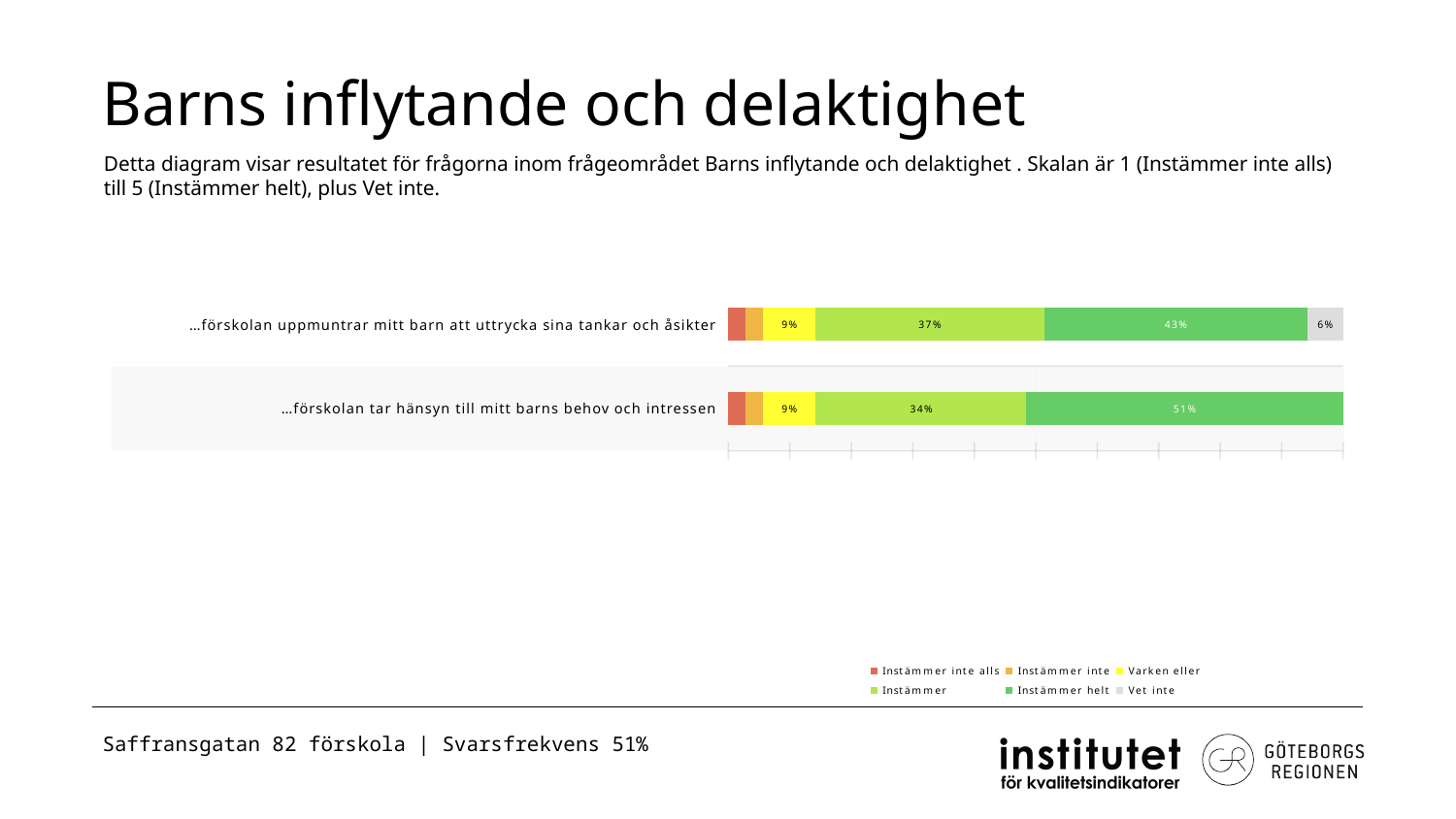
What is the difference between the "Instämmer" and "Instämmer helt" shares for "…förskolan uppmuntrar mitt barn att uttrycka sina tankar och åsikter"? 6 percentage points Which of the two statements has the higher "Instämmer helt" share? …förskolan tar hänsyn till mitt barns behov och intressen What is the difference in the "Instämmer helt" share between the two statements? 8 percentage points What percentage of respondents answered "Instämmer" for "…förskolan uppmuntrar mitt barn att uttrycka sina tankar och åsikter"? 37% Which response category has the largest share for "…förskolan tar hänsyn till mitt barns behov och intressen"? Instämmer helt What percentage of respondents answered "Instämmer helt" for "…förskolan tar hänsyn till mitt barns behov och intressen"? 51% What is the "Varken eller" share for "…förskolan tar hänsyn till mitt barns behov och intressen"? 9% What is the title of the slide? Barns inflytande och delaktighet How many response categories does the legend list? 6 What is the "Vet inte" share for "…förskolan uppmuntrar mitt barn att uttrycka sina tankar och åsikter"? 6% What type of chart is shown on the slide? Stacked bar chart How many statements (bars) are shown in the chart? 2